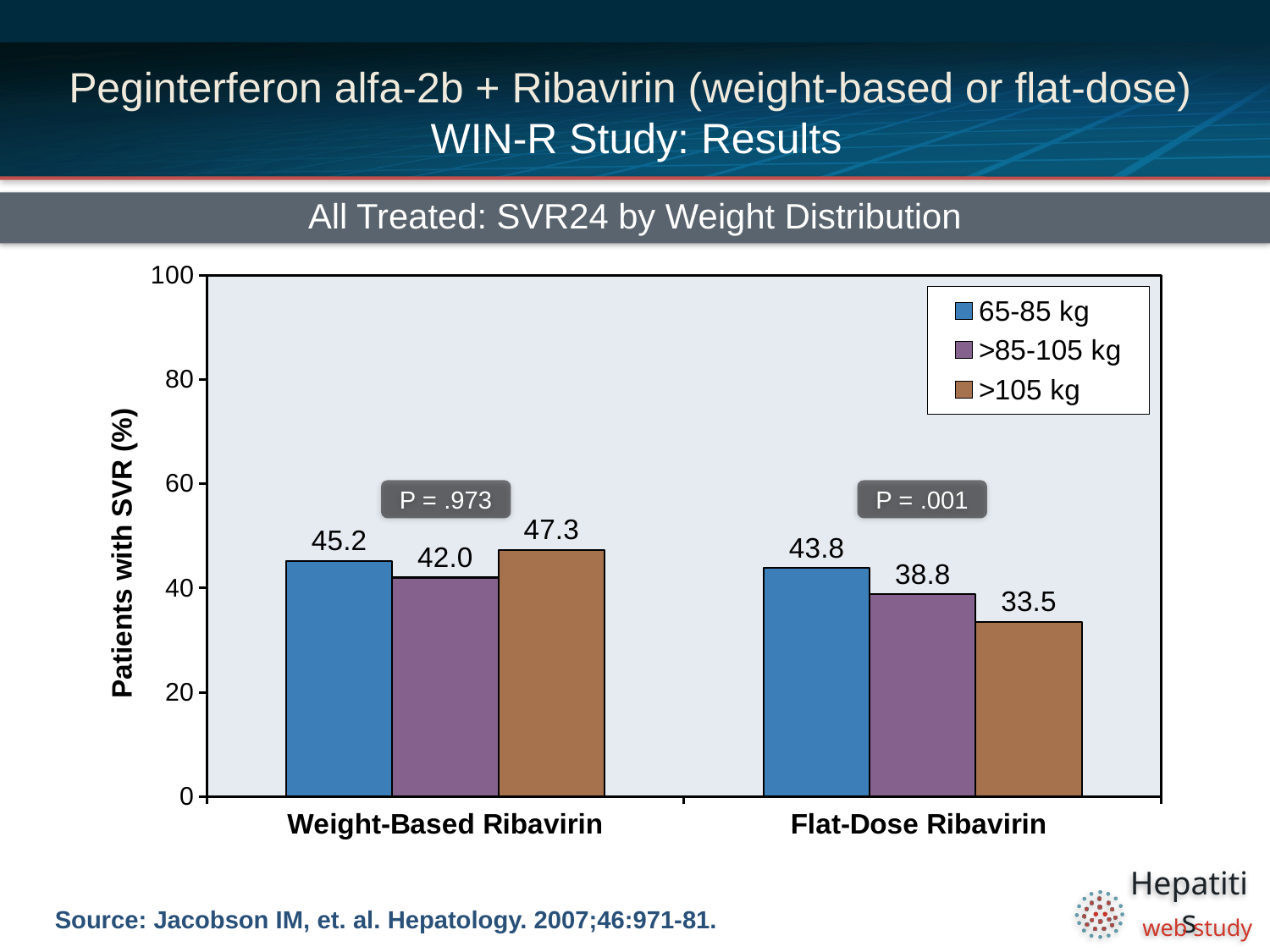
What P value is shown for the Flat-Dose Ribavirin group? P = .001 How many series does the legend list? 3 What is the SVR rate for the 65-85 kg group with Weight-Based Ribavirin? 45.2 Which weight group has the lowest SVR rate with Flat-Dose Ribavirin? >105 kg How many treatment categories are shown on the x axis? 2 Which is larger: the SVR rate for the 65-85 kg group with Weight-Based Ribavirin or with Flat-Dose Ribavirin? Weight-Based Ribavirin What is the difference in SVR rate for the >105 kg group between Weight-Based Ribavirin and Flat-Dose Ribavirin? 13.8 What kind of chart is shown on the slide? bar chart What is the SVR rate for the >85-105 kg group with Weight-Based Ribavirin? 42.0 What is the SVR rate for the >105 kg group with Flat-Dose Ribavirin? 33.5 Which weight group has the highest SVR rate with Weight-Based Ribavirin? >105 kg Is the SVR rate for the >85-105 kg group with Flat-Dose Ribavirin greater or less than 40? less